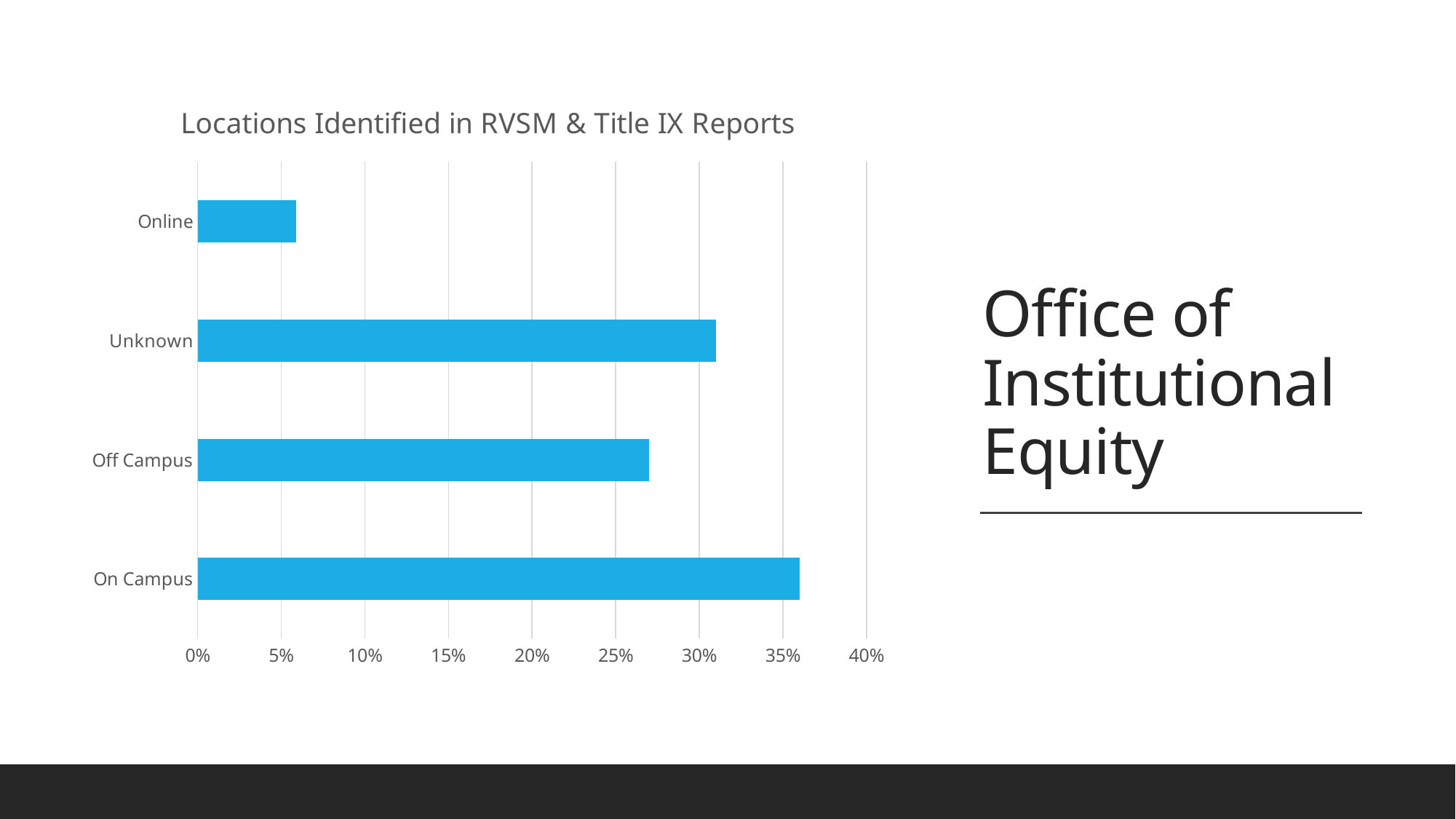
What is the highest value shown on the horizontal axis? 40% Which is larger, the value for Unknown or the value for Off Campus? Unknown Is the value for Unknown greater or less than 30%? greater How many location categories are shown in the chart? 4 Is the value for On Campus greater or less than 35%? greater What is the title of the chart? Locations Identified in RVSM & Title IX Reports Which location has the lowest percentage? Online Which location has the highest percentage? On Campus Is the value for Off Campus greater or less than 30%? less What kind of chart is shown on the slide? bar chart Which is larger, the value for On Campus or the value for Unknown? On Campus